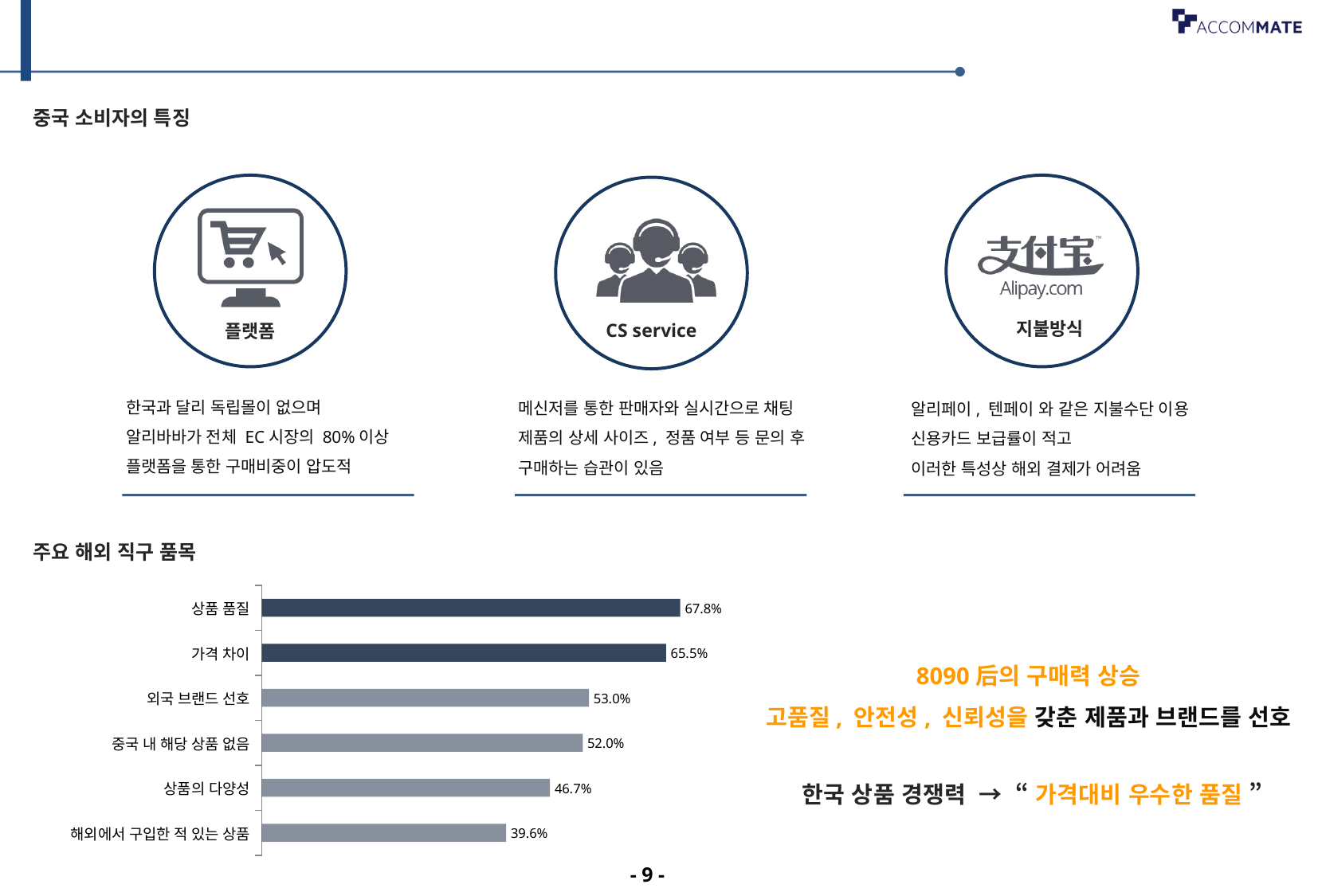
What is the value for 상품 품질? 67.8% What is the value for 해외에서 구입한 적 있는 상품? 39.6% Which category has the lowest value? 해외에서 구입한 적 있는 상품 How many categories are shown in the chart? 6 What is the value for 외국 브랜드 선호? 53.0% What is the difference between the values for 상품 품질 and 가격 차이? 2.3% Which category has the highest value? 상품 품질 What kind of chart is shown on the slide? Bar chart What is the value for 가격 차이? 65.5% What is the difference between the values for 외국 브랜드 선호 and 해외에서 구입한 적 있는 상품? 13.4% Which is larger, the value for 중국 내 해당 상품 없음 or the value for 상품의 다양성? 중국 내 해당 상품 없음 What is the title of the chart? 주요 해외 직구 품목